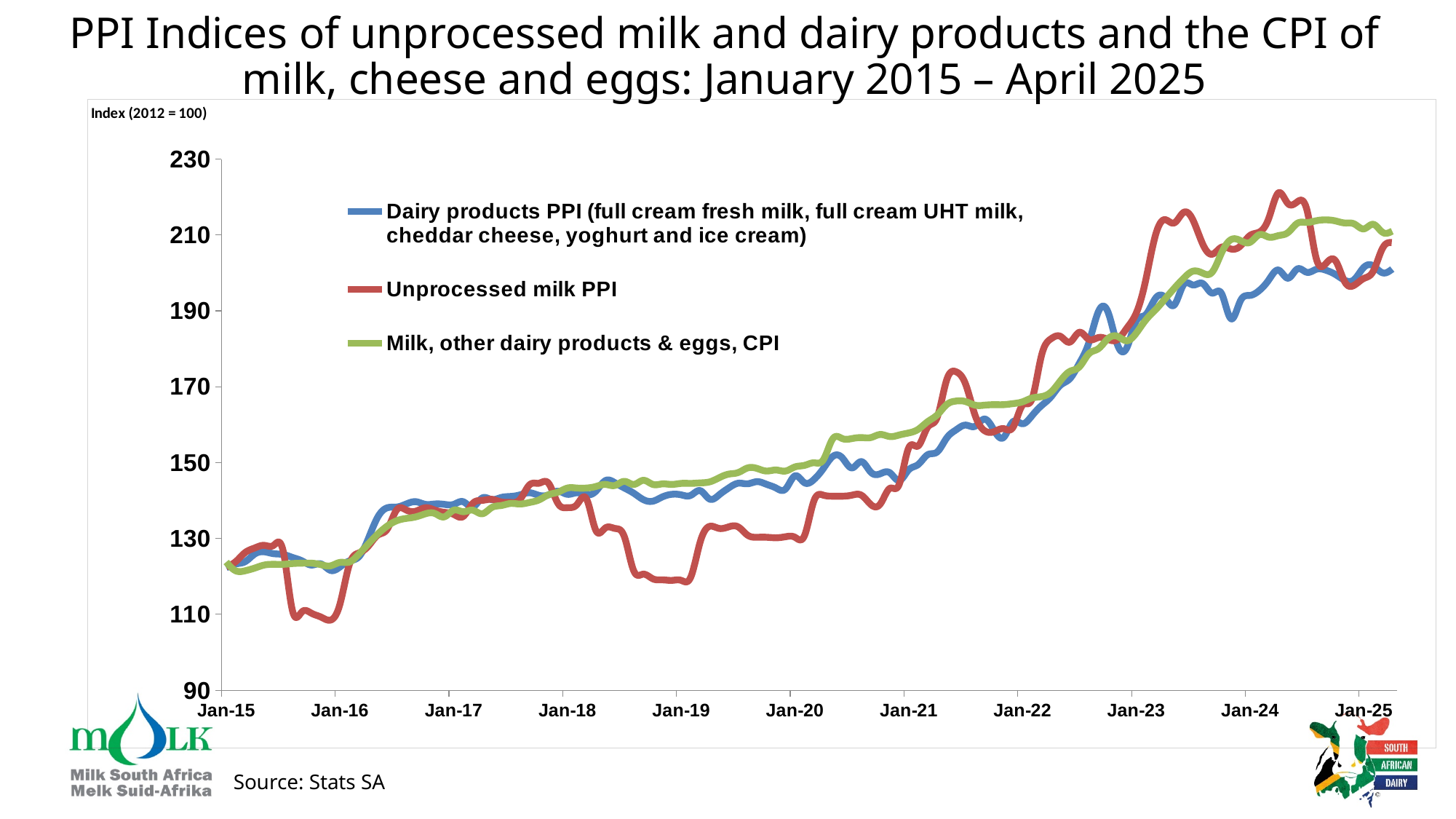
At Jan-19, which is higher: the Dairy products PPI or the Unprocessed milk PPI? Dairy products PPI How many series does the legend list? 3 Is the value of the Dairy products PPI at Jan-15 greater or less than 130? less Is the value of the Unprocessed milk PPI at Jan-19 greater or less than 130? less At Jan-25, which is higher: the Dairy products PPI or the Milk, other dairy products & eggs, CPI? Milk, other dairy products & eggs, CPI Is the value of the Milk, other dairy products & eggs, CPI at Jan-24 greater or less than 190? greater What is the source of the data cited on the slide? Stats SA Which series reaches the lowest value anywhere on the chart? Unprocessed milk PPI Does the Dairy products PPI series rise or fall overall from Jan-15 to Jan-25? rise What kind of chart is shown on the slide? line chart What base year is the index set to 100, according to the axis label? 2012